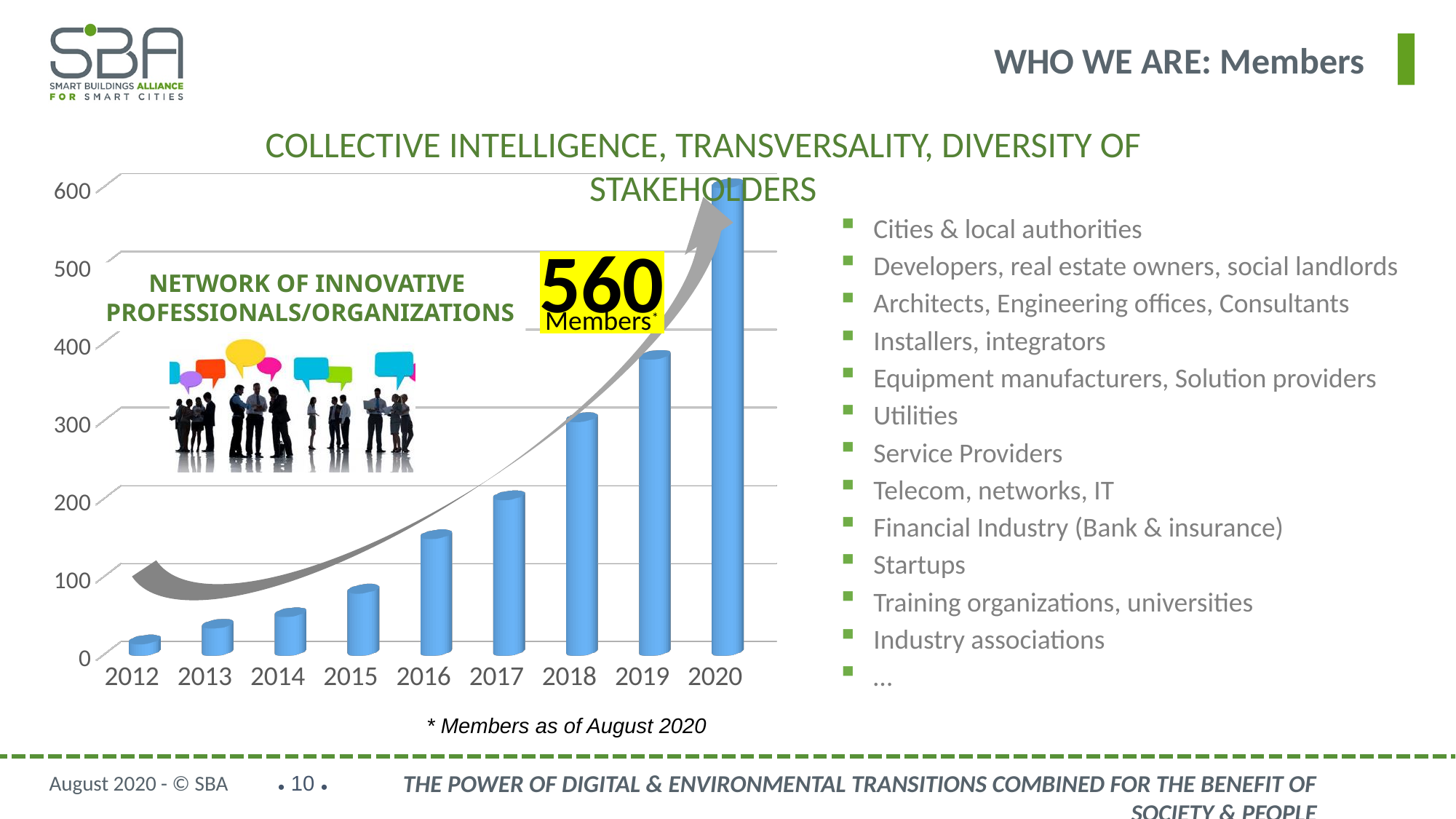
Which year has the lowest bar in the chart? 2012 Is the value for 2015 greater or less than 100? less Is the value for 2020 greater or less than 500? greater What is the first year shown on the x axis of the chart? 2012 What number of members is highlighted in the yellow callout on the chart? 560 How many years are shown on the x axis of the chart? 9 Which year has the highest bar in the chart? 2020 Is the value for 2016 greater or less than 200? less Which year has a larger value, 2017 or 2019? 2019 Do the bar values rise or fall from 2012 to 2020? rise What kind of chart is shown on the slide? bar chart